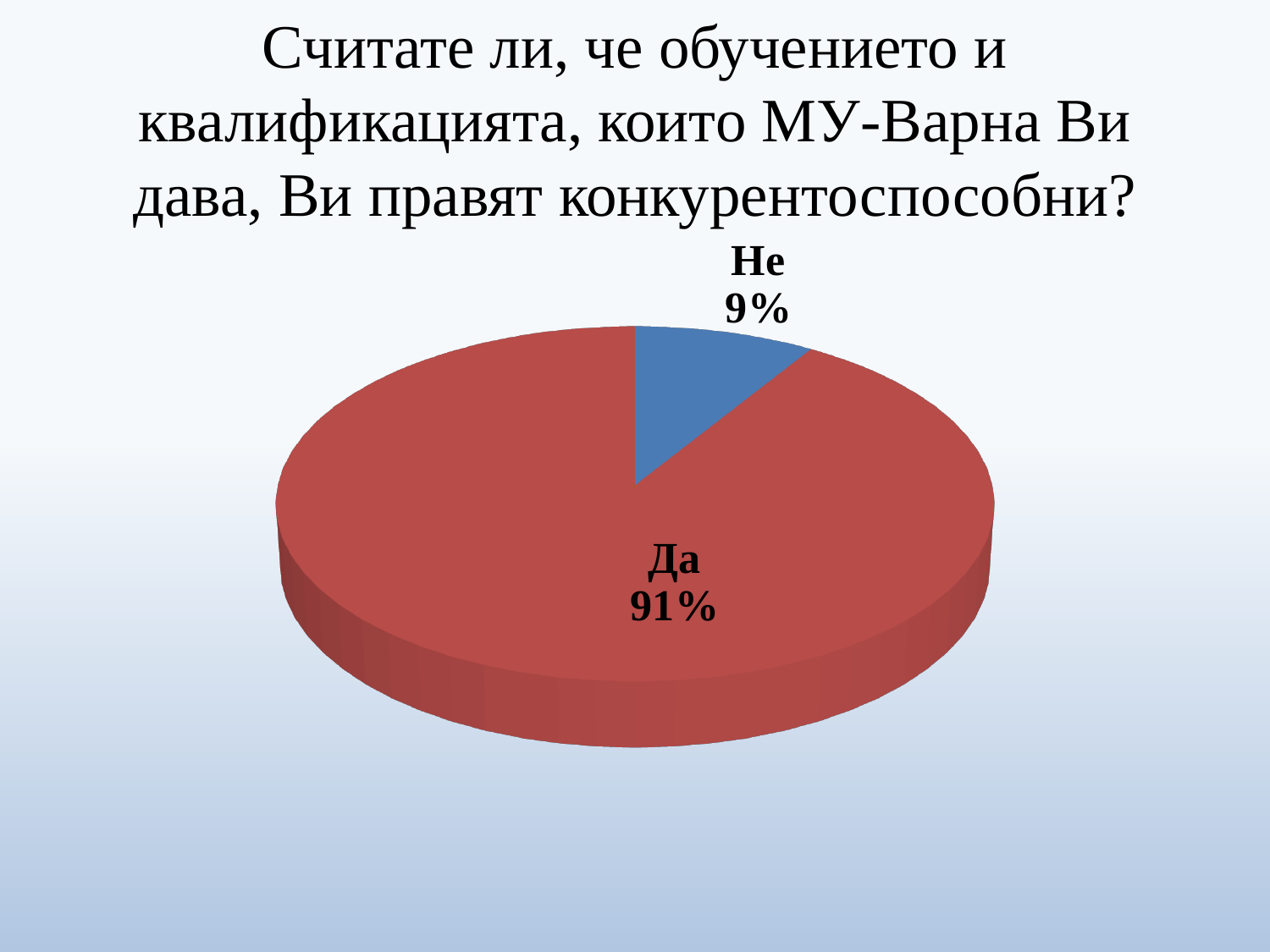
How many slices does the pie chart have? 2 What kind of chart is shown on the slide? Pie chart What share of the pie does the "Да" slice represent? 91% What is the difference in percentage points between the "Да" and "Не" slices? 82 Which slice is the smallest in the pie chart? Не Which is larger, the "Да" slice or the "Не" slice? Да Which slice is the largest in the pie chart? Да What colour is the "Да" slice? Red What colour is the "Не" slice? Blue What share of the pie does the "Не" slice represent? 9%